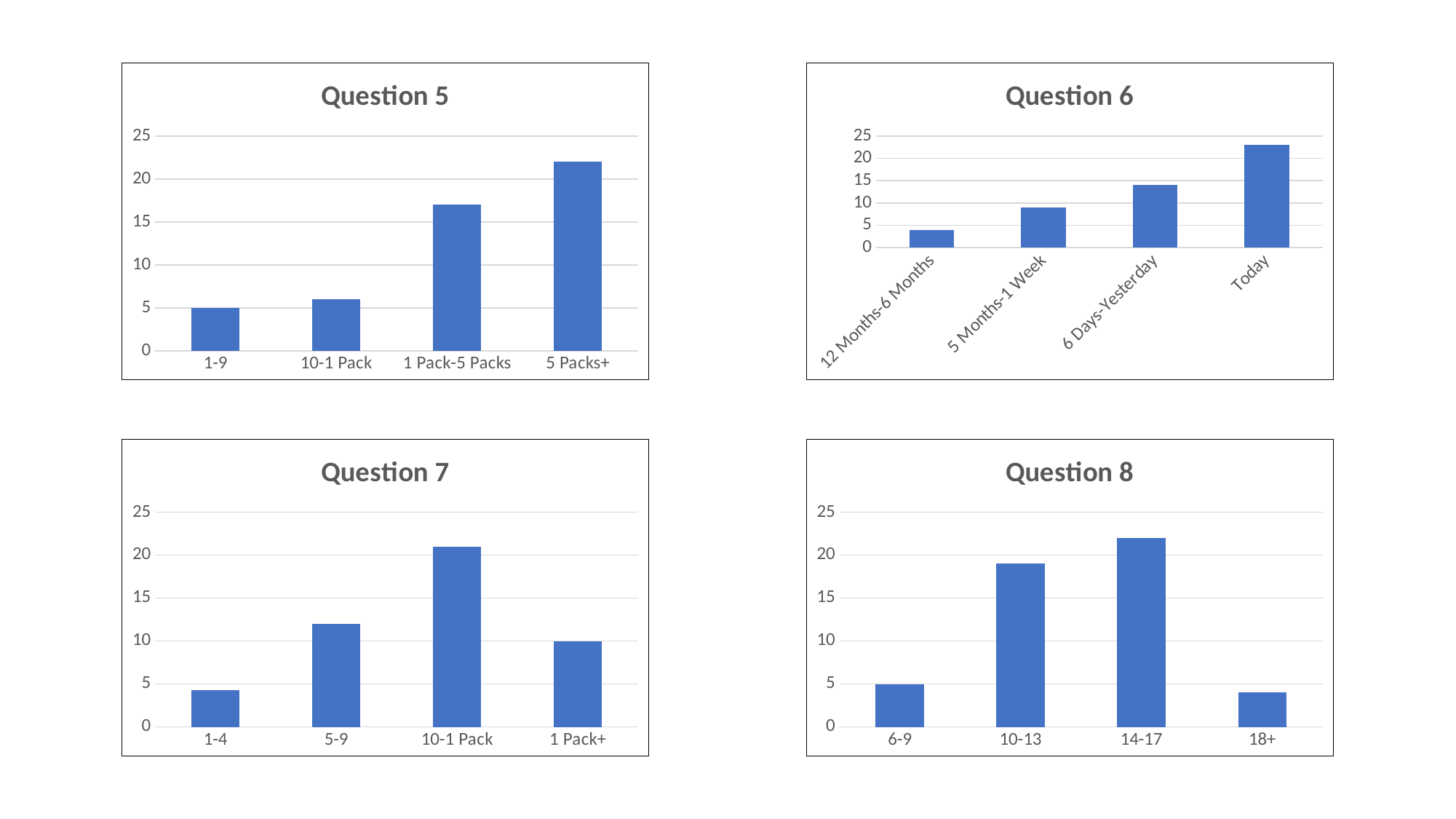
How many categories are shown in the Question 8 chart? 4 In the Question 5 chart, what is the value for 1-9? 5 In the Question 6 chart, which is larger, 5 Months-1 Week or 6 Days-Yesterday? 6 Days-Yesterday In the Question 7 chart, which category has the highest value? 10-1 Pack In the Question 6 chart, is the value for Today greater or less than 20? greater In the Question 8 chart, what is the value for 6-9? 5 In the Question 8 chart, is the value for 10-13 greater or less than 15? greater In the Question 5 chart, is the value for 1 Pack-5 Packs greater or less than 15? greater In the Question 7 chart, what is the value for 1 Pack+? 10 In the Question 5 chart, which category has the highest value? 5 Packs+ In the Question 5 chart, do the values rise or fall from left to right along the x axis? rise In the Question 6 chart, which category has the lowest value? 12 Months-6 Months